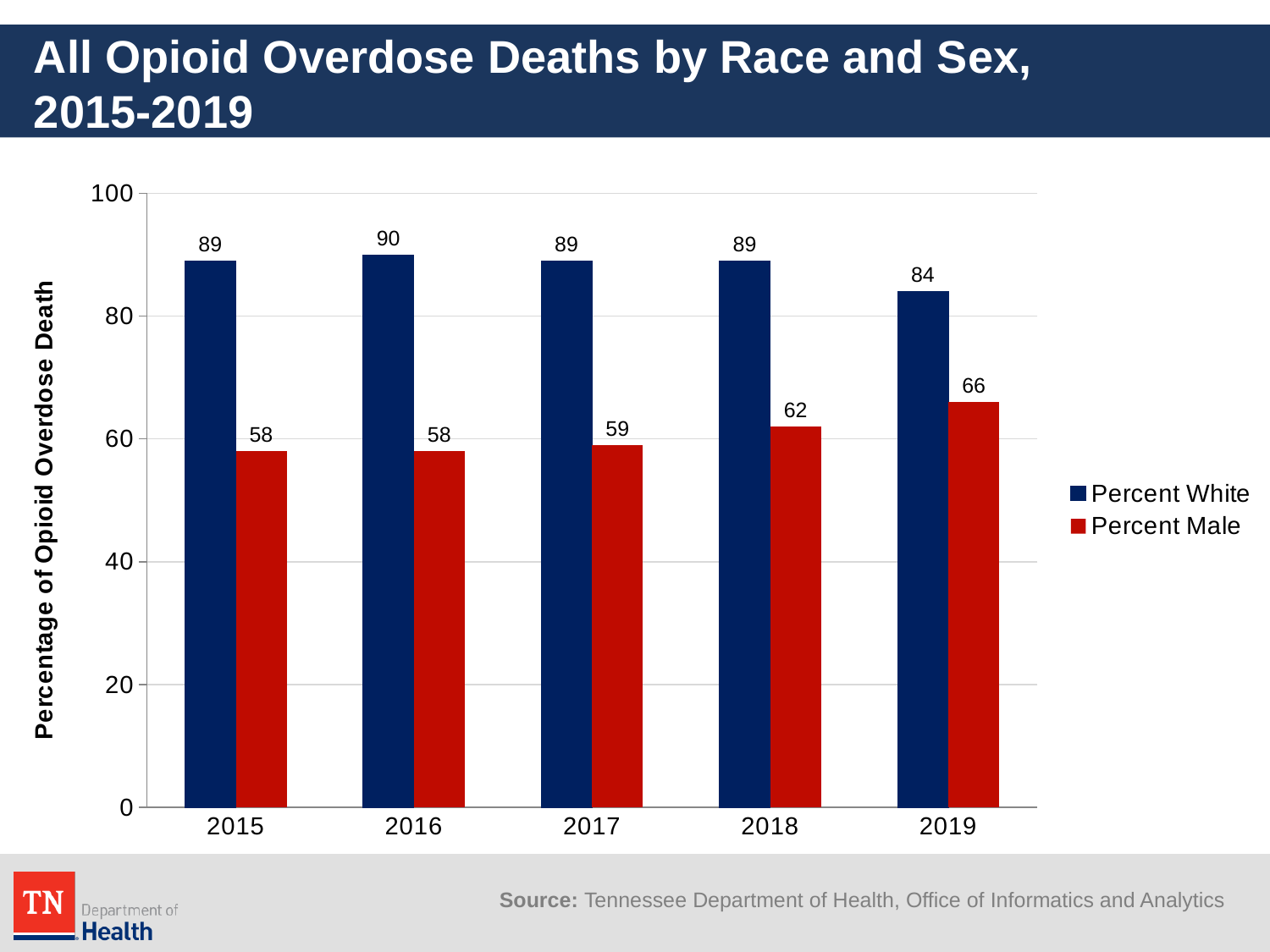
In which year is the Percent White value highest? 2016 What is the difference between Percent White and Percent Male in 2015? 31 How many series does the legend list? 2 In which year is the Percent White value lowest? 2019 Which is larger in 2018: Percent White or Percent Male? Percent White In which year is the Percent Male value highest? 2019 What is the Percent White value for 2017? 89 Does the Percent Male value rise or fall from 2017 to 2019? rise What kind of chart is shown on the slide? bar chart Is the Percent Male value for 2016 greater or less than 60? less How many years are shown on the x axis? 5 What is the Percent Male value for 2019? 66